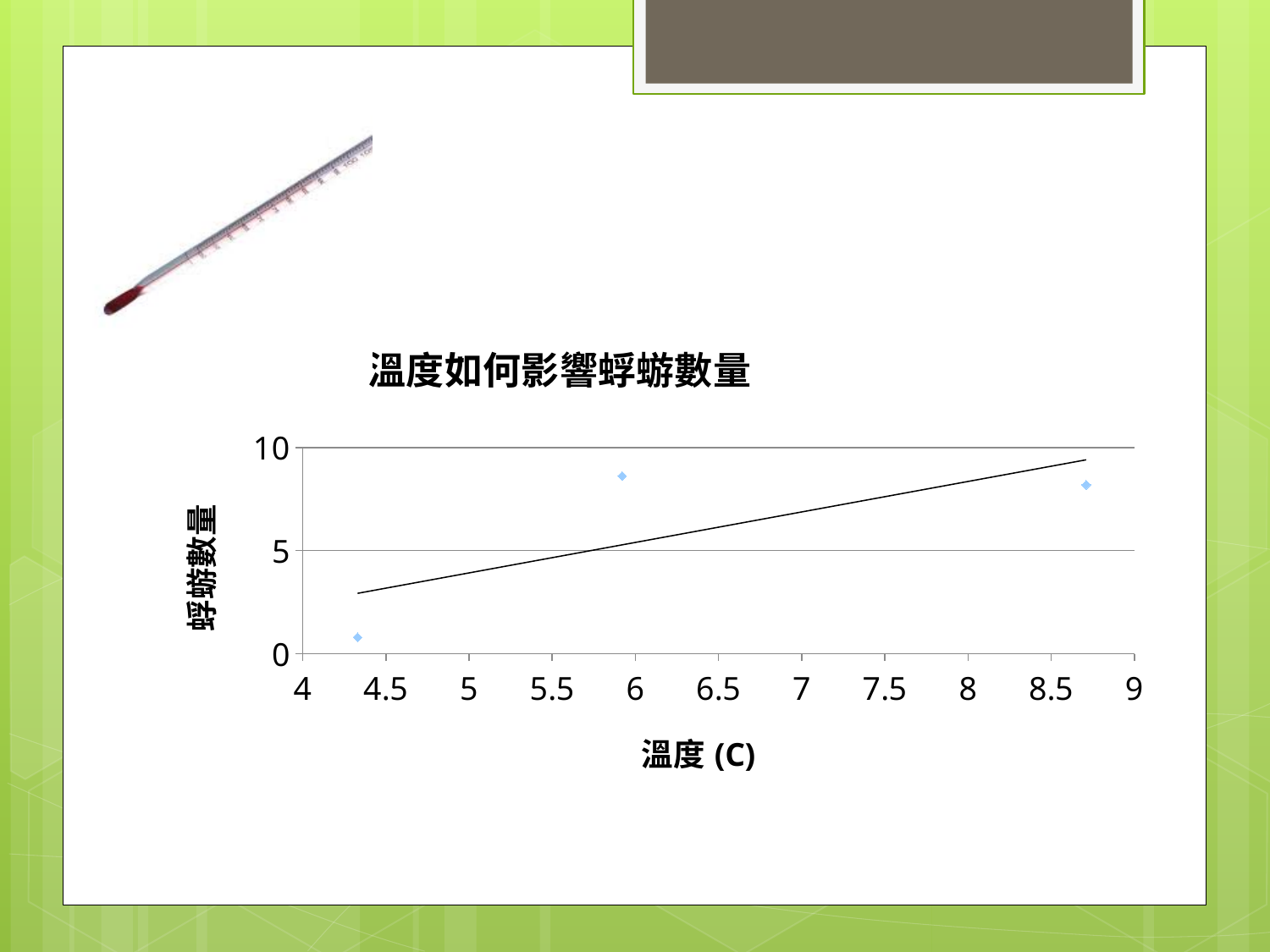
Does the trendline rise or fall as temperature increases along the x axis? rise Is the mayfly count for the data point with the highest temperature greater or less than 5? greater Which data point has the lowest mayfly count: the one at the lowest temperature or the one at the highest temperature? the one at the lowest temperature What is the title of the chart? 溫度如何影響蜉蝣數量 What is the maximum value shown on the y axis? 10 Is the mayfly count for the data point with the lowest temperature greater or less than 5? less How many data points are plotted on the chart? 3 Is the mayfly count for the data point near 6 °C greater or less than 5? greater What kind of chart is shown on the slide? scatter chart Is the mayfly count for the data point near 6 °C larger or smaller than the count for the data point near 4.3 °C? larger What is the label of the x axis? 溫度 (C)